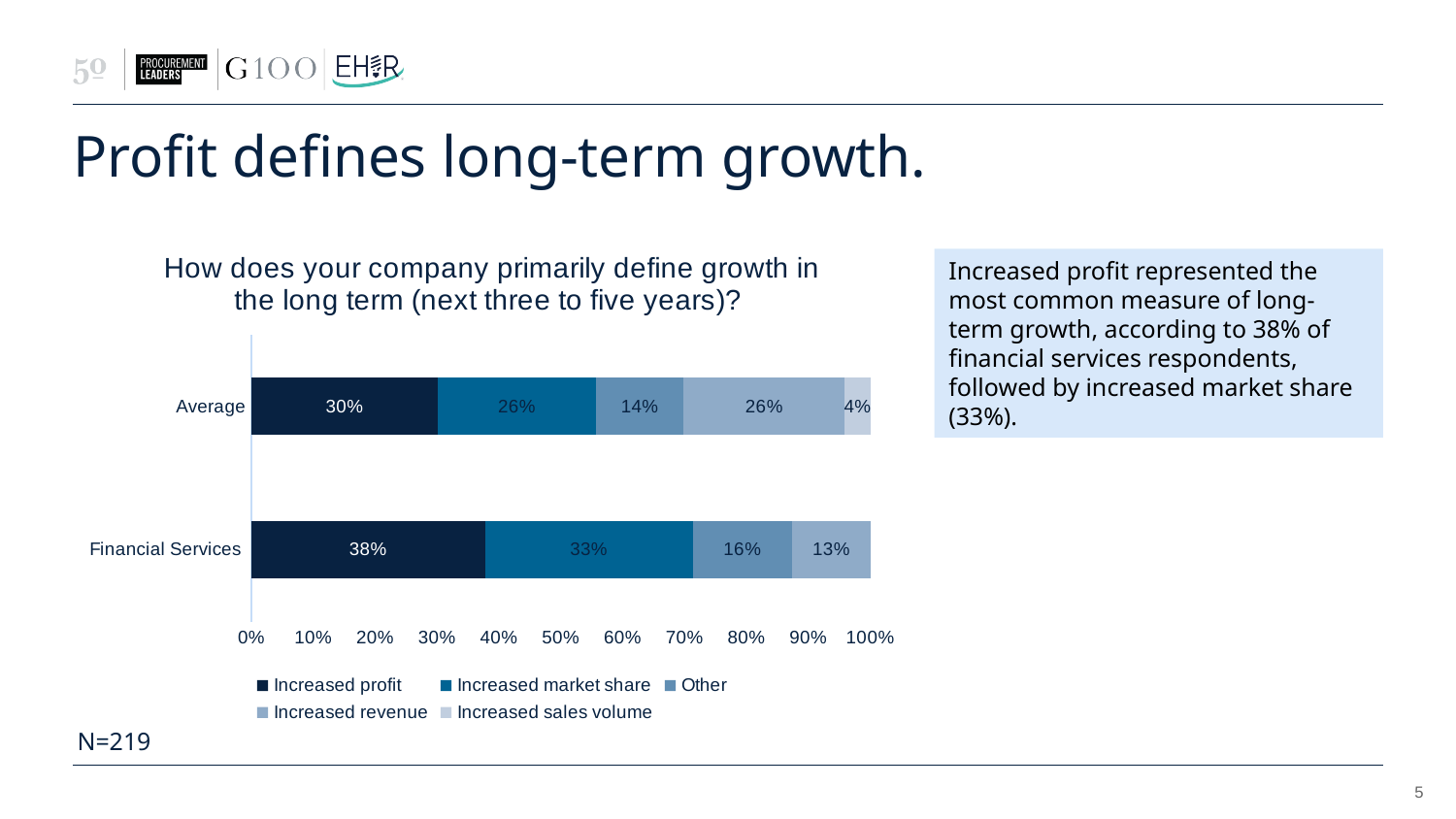
What is the Average value for Increased sales volume? 4% What percentage of Financial Services respondents chose Increased profit? 38% What is the value for Other in the Financial Services bar? 16% Which segment is the largest in the Average bar? Increased profit What is the difference between the Financial Services and Average values for Increased profit? 8% What is the value for Increased revenue in the Financial Services bar? 13% How many categories (bars) are shown on the chart? 2 Which segment is the smallest in the Average bar? Increased sales volume What is the Average value for Increased market share? 26% Which is larger: the Financial Services value for Increased market share or the Average value for Increased market share? Financial Services How many series does the legend list? 5 What kind of chart is shown on the slide? Stacked bar chart